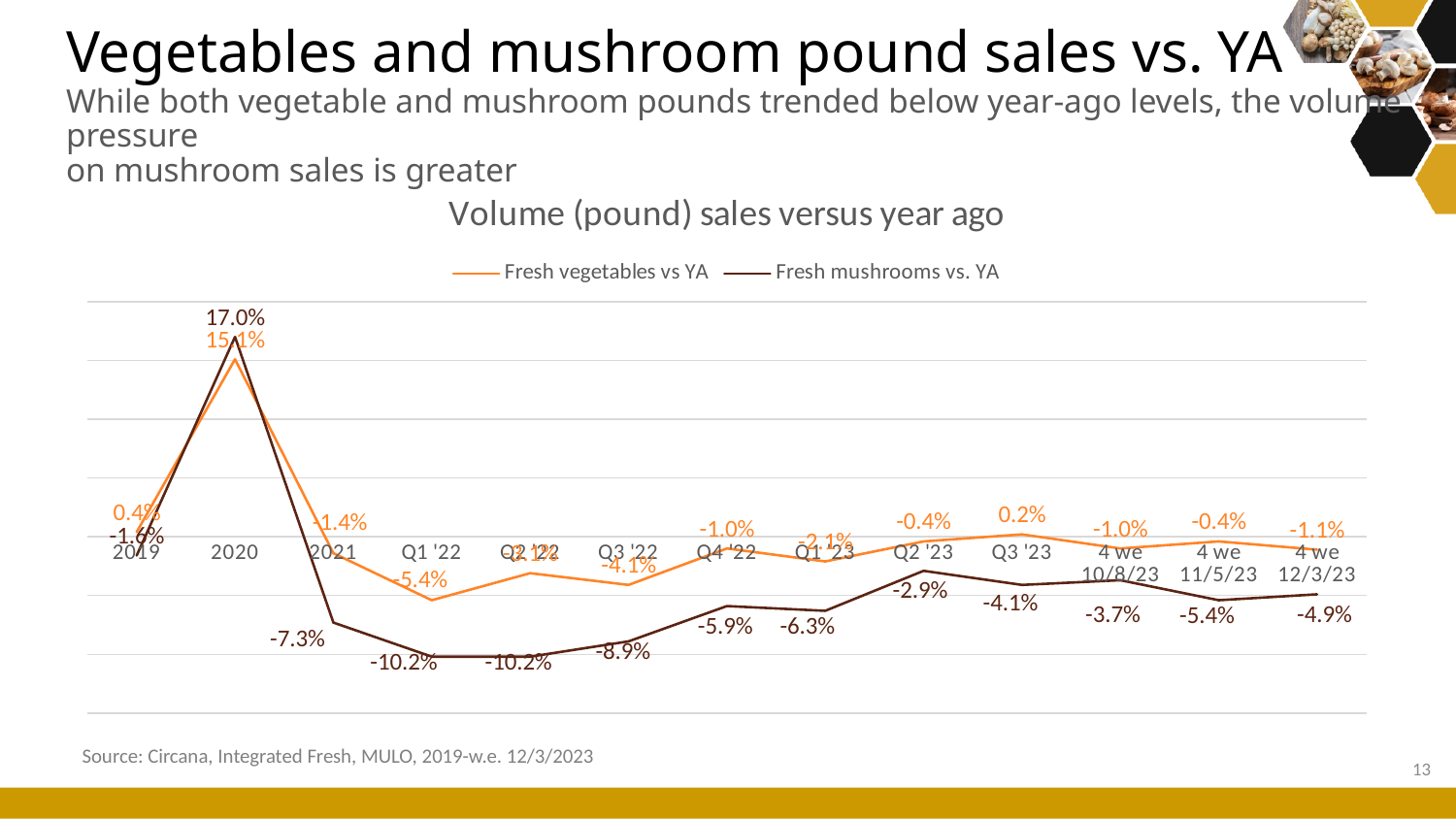
How many series does the legend list? 2 In Q3 '23, which series has the larger value, Fresh vegetables vs YA or Fresh mushrooms vs. YA? Fresh vegetables vs YA What is the value for Fresh vegetables vs YA for the 4 we 12/3/23 period? -1.1% In 2020, how much higher is the Fresh mushrooms vs. YA value than the Fresh vegetables vs YA value? 1.9 percentage points In which period is the Fresh mushrooms vs. YA value highest? 2020 What is the value for Fresh mushrooms vs. YA in 2020? 17.0% What is the value for Fresh vegetables vs YA in 2020? 15.1% What kind of chart is shown on the slide? Line chart What is the value for Fresh mushrooms vs. YA in Q3 '23? -4.1% In which period is the Fresh vegetables vs YA value lowest? Q1 '22 What is the value for Fresh mushrooms vs. YA in Q1 '22? -10.2% How many periods are shown on the x axis? 13